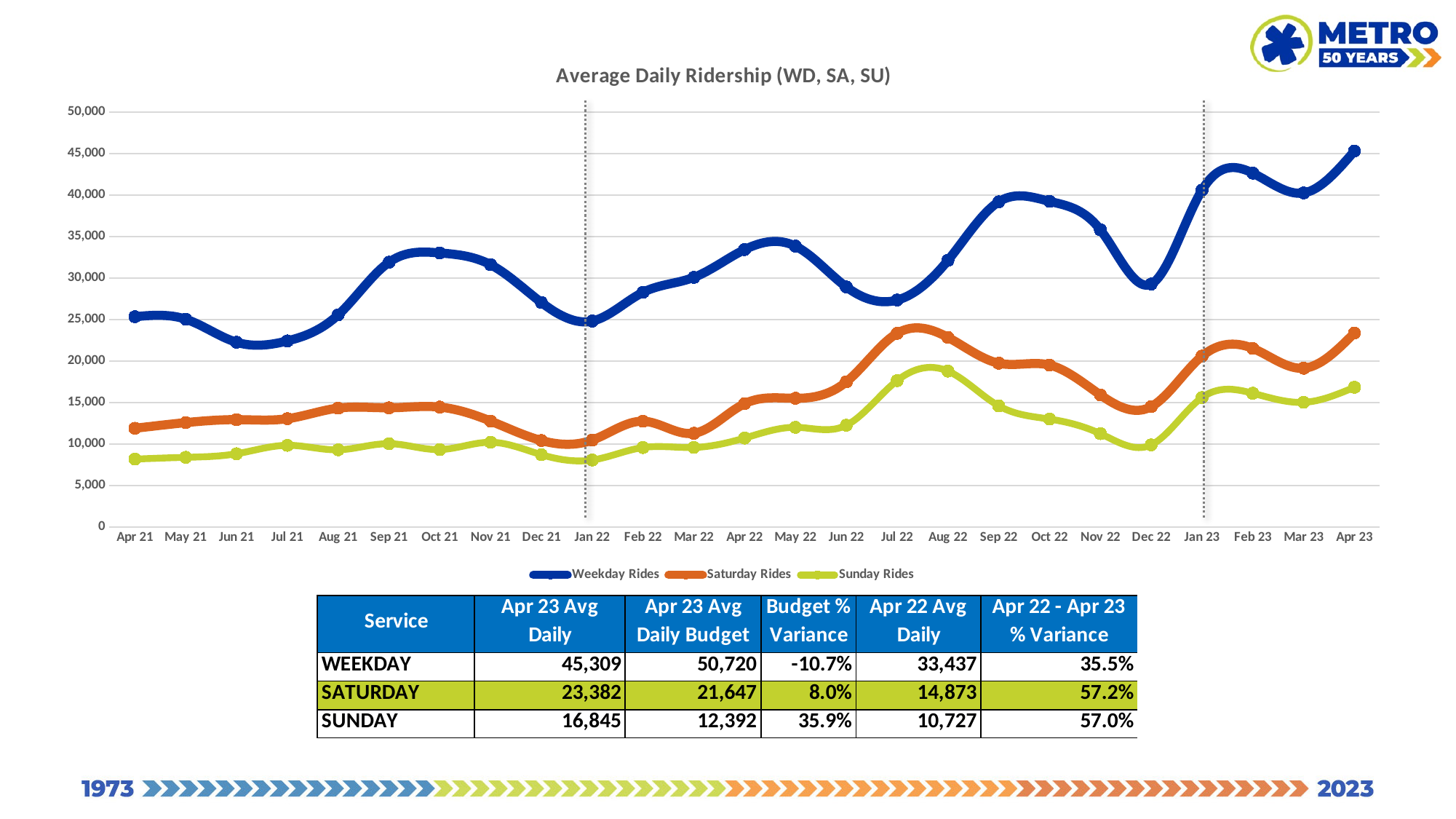
In which month do Weekday Rides reach their highest value? Apr 23 What kind of chart is shown on the slide? line chart What is the value of Sunday Rides for Apr 22? 10,727 What is the difference between Weekday Rides in Apr 23 and Apr 22? 11,872 What is the value of Weekday Rides for Apr 23? 45,309 Is the value of Saturday Rides for Jul 22 greater or less than 20,000? greater How many months are plotted along the x axis of the chart? 25 Is the value of Sunday Rides for Aug 22 greater or less than 20,000? less Which series has the highest values across the whole chart? Weekday Rides How many series does the chart legend list? 3 What is the value of Saturday Rides for Apr 22? 14,873 Which is larger in Apr 23, Saturday Rides or Sunday Rides? Saturday Rides